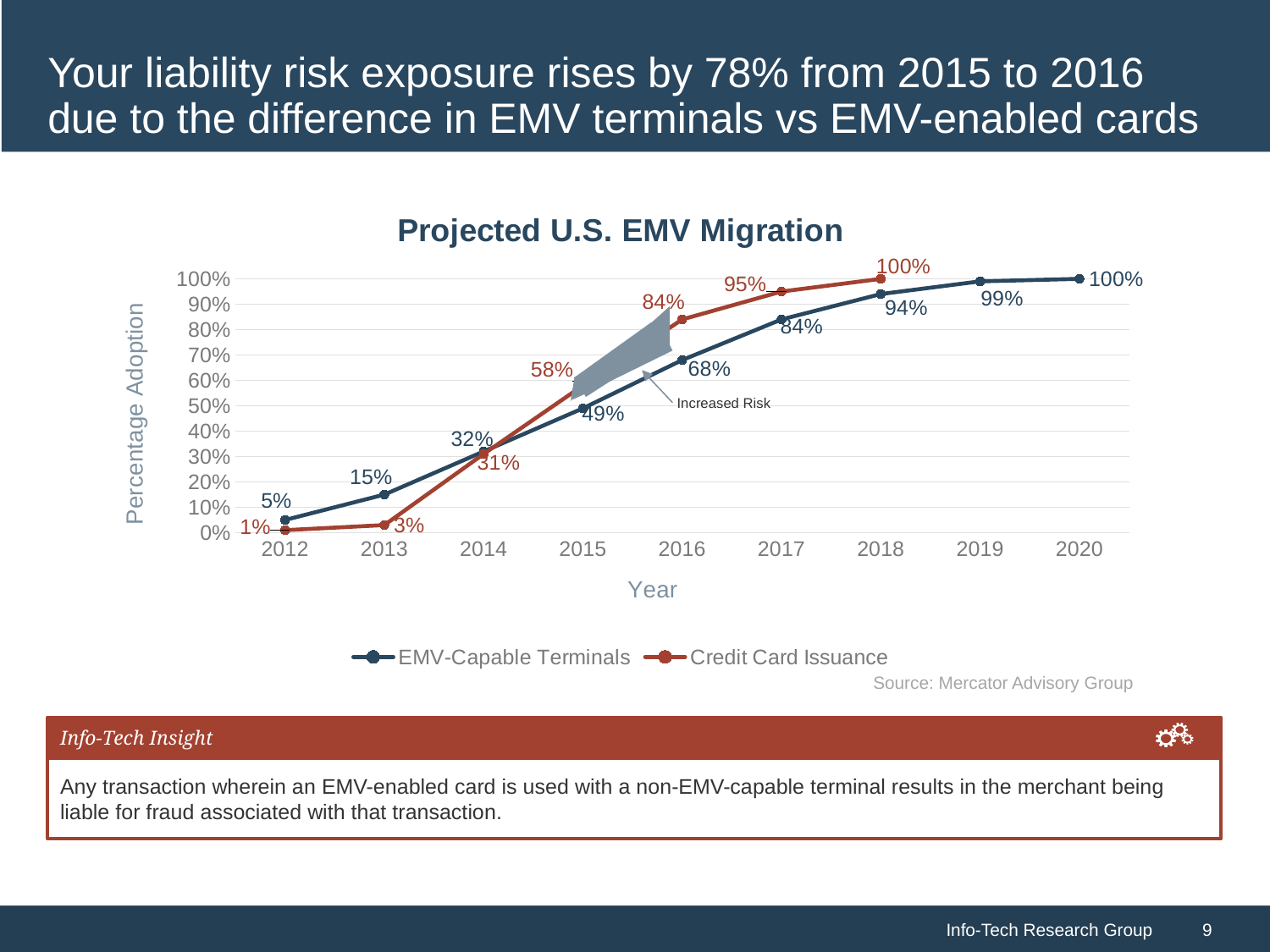
What is the difference between EMV-Capable Terminals and Credit Card Issuance in 2013? 12% In 2014, which series has the higher value, EMV-Capable Terminals or Credit Card Issuance? EMV-Capable Terminals What is the value for EMV-Capable Terminals in 2012? 5% How many series does the legend list? 2 What is the value for EMV-Capable Terminals in 2016? 68% In 2015, which series has the higher value, EMV-Capable Terminals or Credit Card Issuance? Credit Card Issuance What is the difference between Credit Card Issuance and EMV-Capable Terminals in 2016? 16% Do the values for EMV-Capable Terminals rise or fall from 2012 to 2020? Rise What is the value for Credit Card Issuance in 2015? 58% What is the value for Credit Card Issuance in 2017? 95% How many years are shown on the x axis? 9 What kind of chart is shown on the slide? Line chart